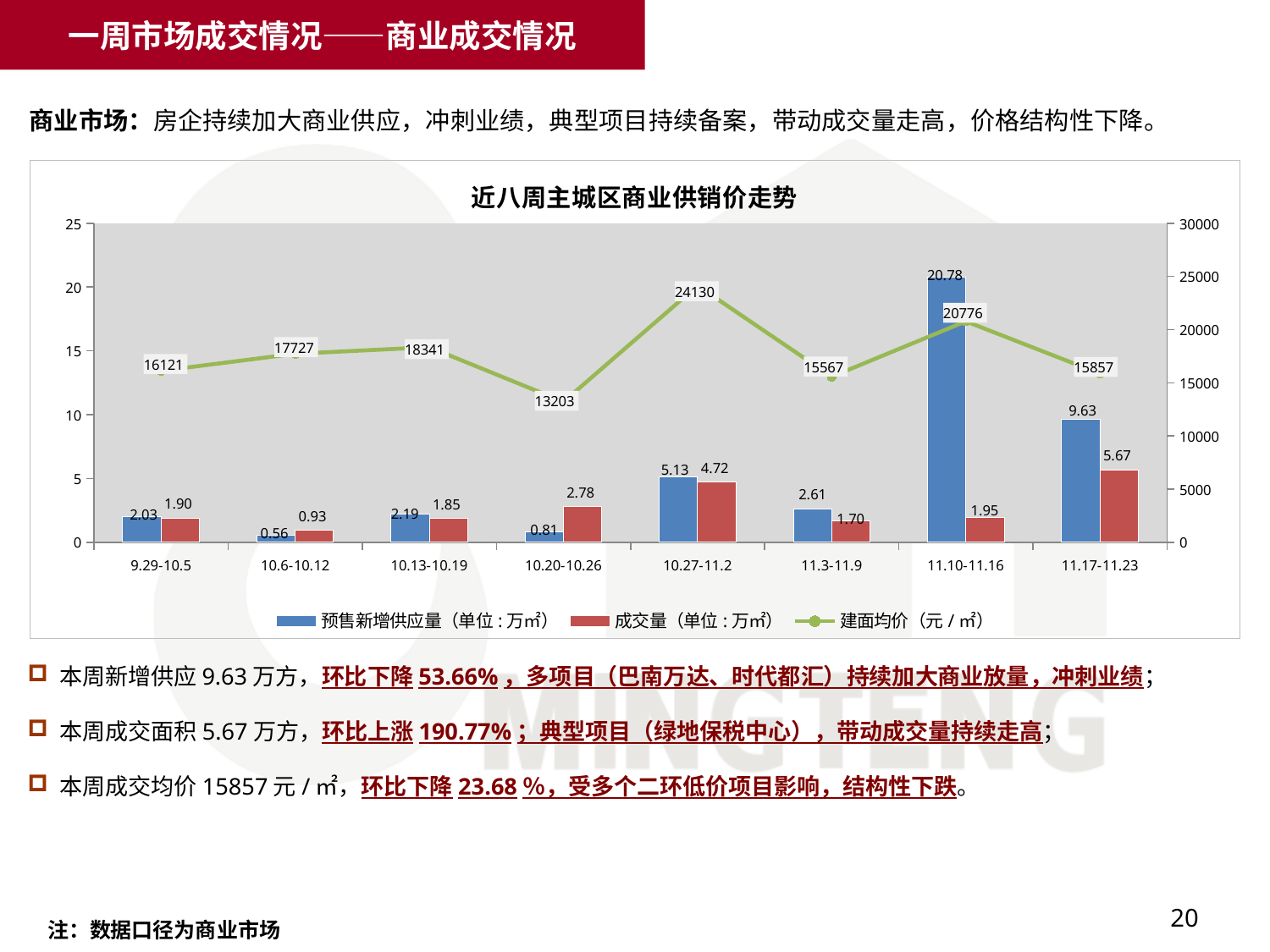
What is the 成交量 value for the week 11.17-11.23? 5.67 Which week has the lowest 建面均价? 10.20-10.26 How many series does the chart legend list? 3 Which week has the highest 建面均价? 10.27-11.2 What is the difference between 预售新增供应量 and 成交量 in the week 11.10-11.16? 18.83 What is the value of 预售新增供应量 for the week 11.10-11.16? 20.78 What is the 建面均价 value for the week 10.27-11.2? 24130 How many weeks are shown on the x axis of the chart? 8 Which is larger in the week 10.20-10.26, 预售新增供应量 or 成交量? 成交量 What is the title of the chart? 近八周主城区商业供销价走势 What kind of chart is used to show 建面均价? Line chart Which week has the lowest 预售新增供应量? 10.6-10.12